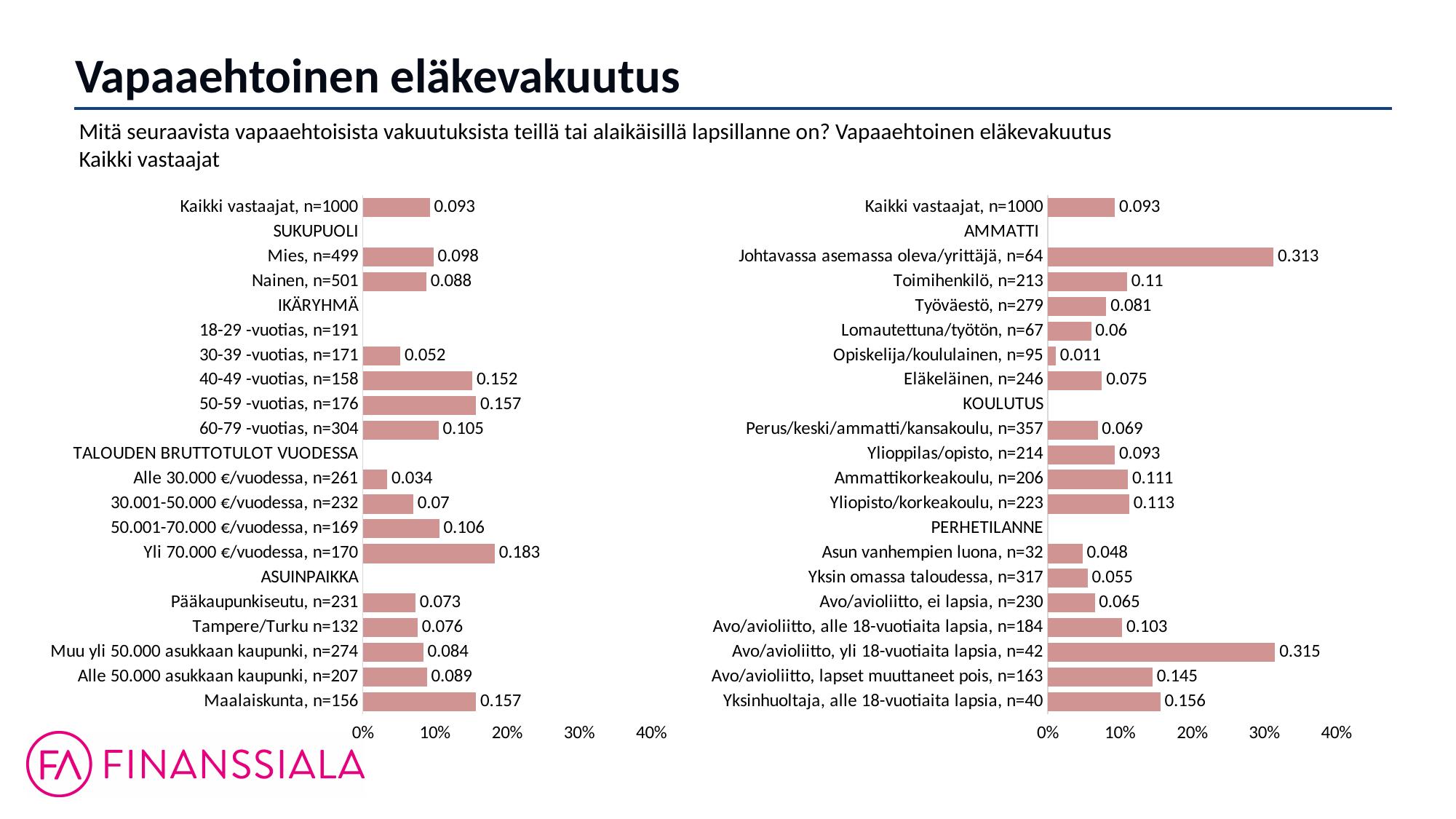
In the right chart, what is the value for Yksinhuoltaja, alle 18-vuotiaita lapsia, n=40? 0.156 In the left chart, which category has the highest value? Yli 70.000 €/vuodessa, n=170 What kind of chart is shown on the left side of the slide? bar chart In the left chart, what is the value for Mies, n=499? 0.098 In the right chart, what is the difference between the values for Johtavassa asemassa oleva/yrittäjä, n=64 and Eläkeläinen, n=246? 0.238 In the left chart, what is the value for Maalaiskunta, n=156? 0.157 In the right chart, which is larger: the value for Toimihenkilö, n=213 or Työväestö, n=279? Toimihenkilö, n=213 In the right chart, what is the value for Toimihenkilö, n=213? 0.11 What is the highest tick label shown on the x axis of the right chart? 40% In the left chart, what is the difference between the values for 50-59 -vuotias, n=176 and 30-39 -vuotias, n=171? 0.105 In the left chart, is the value for Yli 70.000 €/vuodessa, n=170 greater or less than 10%? greater In the right chart, which category has the lowest value? Opiskelija/koululainen, n=95